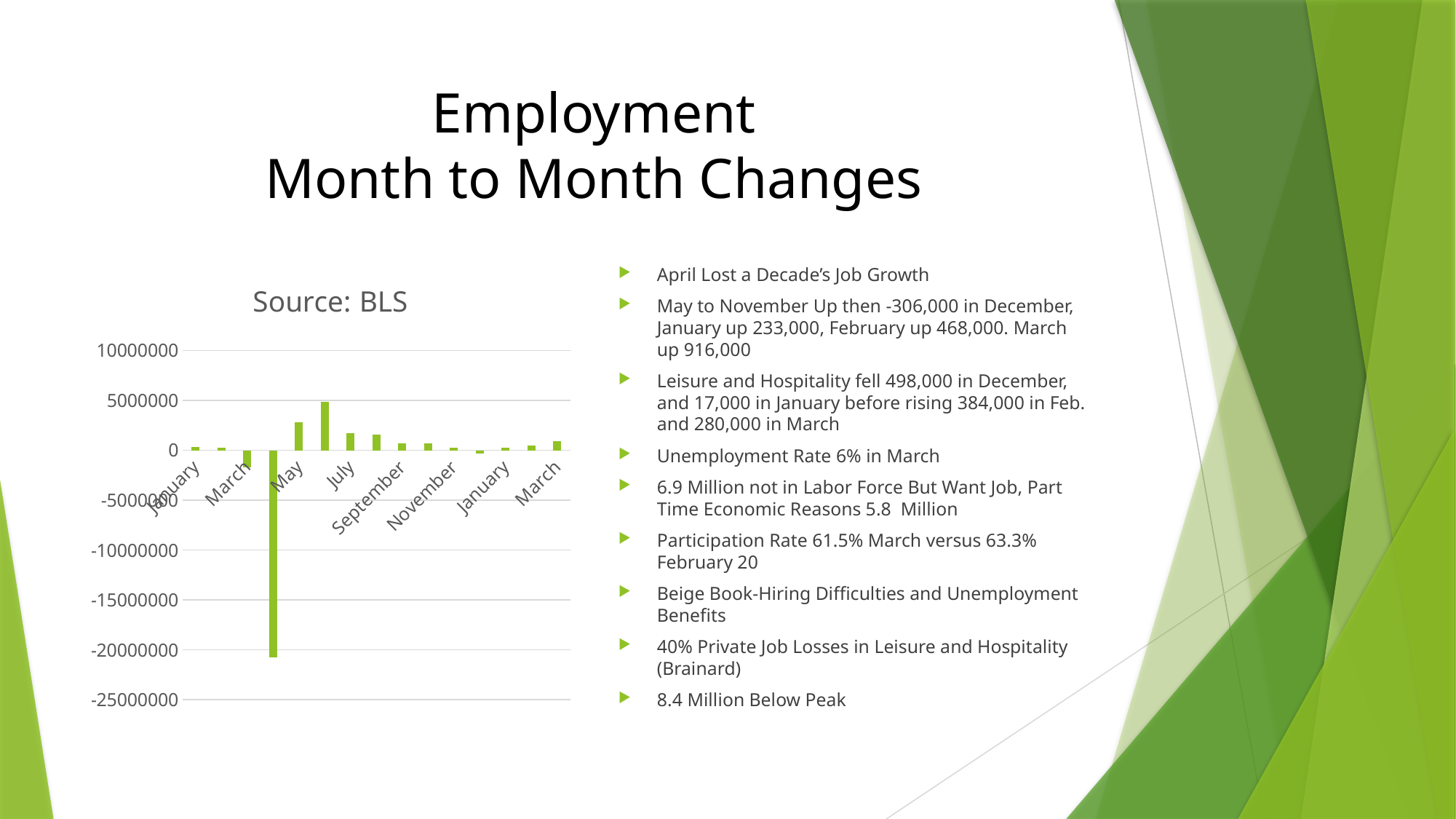
Is the lowest value on the chart greater or less than -20000000? less What is the title of the chart? Source: BLS Which is larger, the value for May or the value for July? May How many bars are plotted in the chart? 15 Is the value for May greater or less than 5000000? less Is the value for May greater or less than 0? greater Which is larger, the value for May or the value for September? May Do the values rise or fall from May to November? fall What kind of chart is shown on the slide? bar chart What is the lowest tick shown on the vertical axis? -25000000